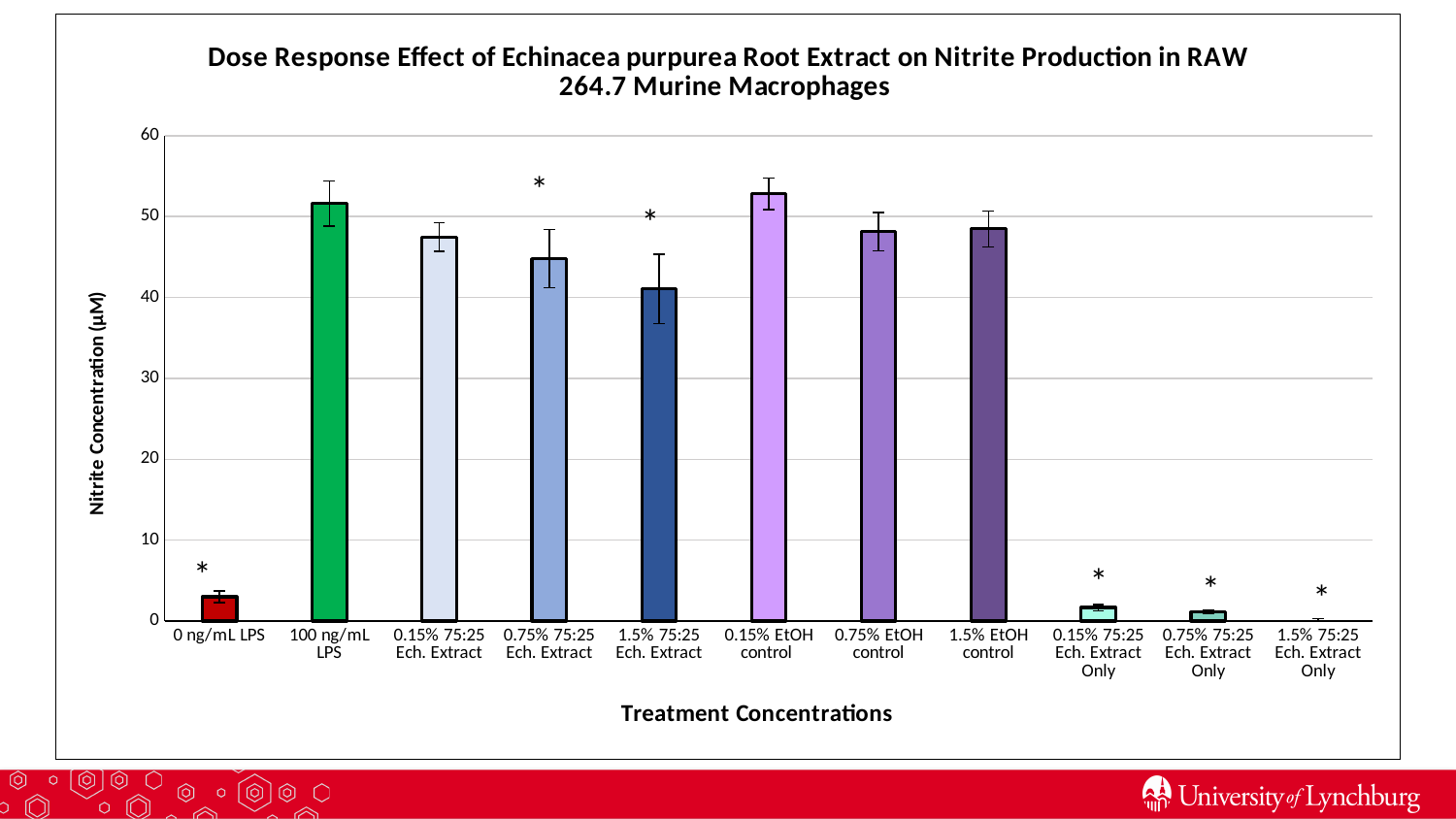
Is the value for 0.15% 75:25 Ech. Extract Only greater or less than 10? less What is the label of the y axis? Nitrite Concentration (µM) Is the value for 1.5% 75:25 Ech. Extract greater or less than 50? less What kind of chart is shown on the slide? bar chart Is the value for 0 ng/mL LPS greater or less than 10? less Which has a higher nitrite concentration, 0.15% 75:25 Ech. Extract or 1.5% 75:25 Ech. Extract? 0.15% 75:25 Ech. Extract Which treatment has the lowest nitrite concentration? 1.5% 75:25 Ech. Extract Only How many treatment categories are plotted along the x axis? 11 Across the three 75:25 Ech. Extract treatments (0.15%, 0.75%, 1.5%), do the nitrite concentrations rise or fall as the concentration increases? fall Which has a higher nitrite concentration, 0.75% EtOH control or 0.75% 75:25 Ech. Extract? 0.75% EtOH control